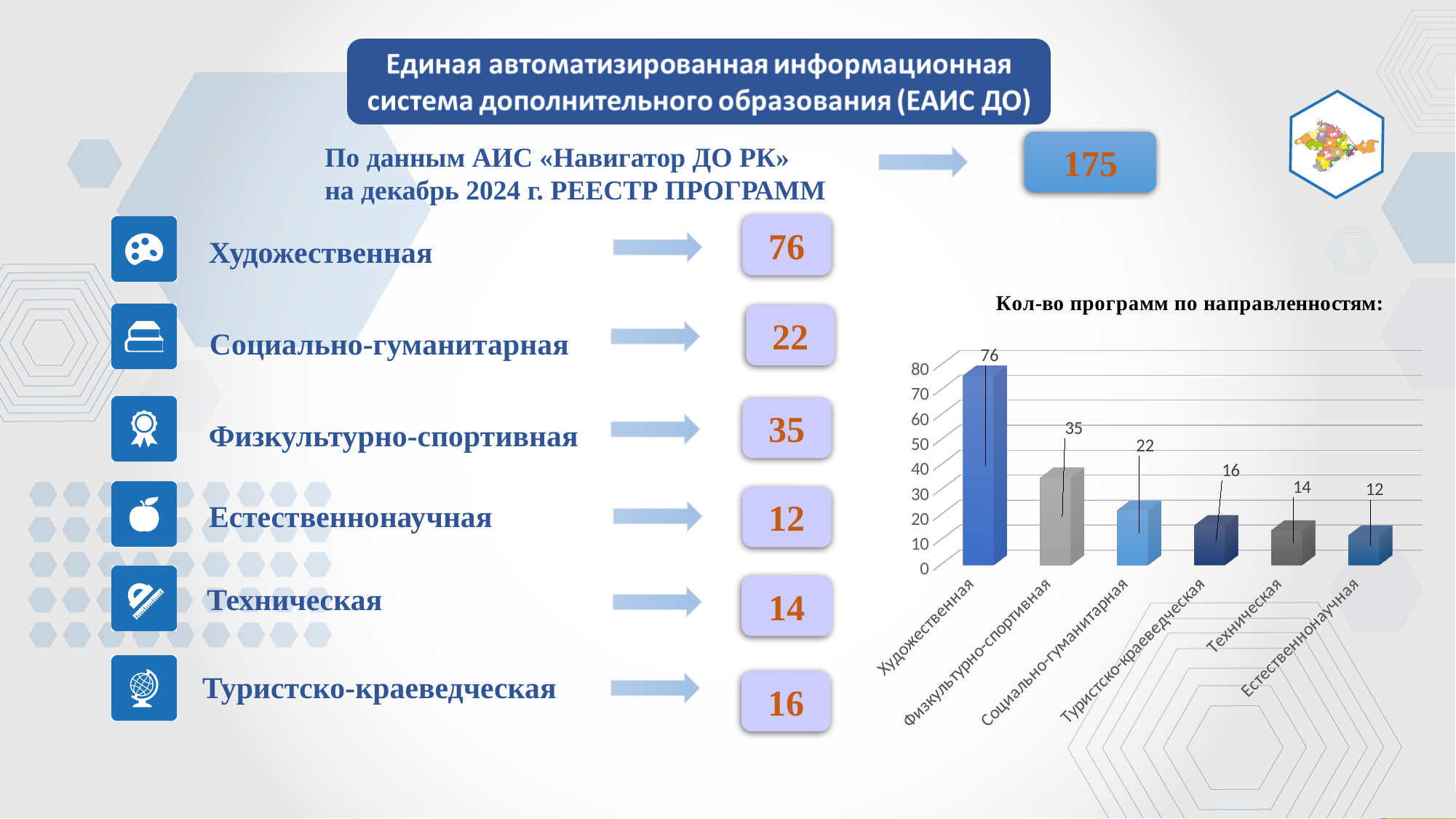
Which category has the lowest value in the chart? Естественнонаучная What kind of chart is shown on the slide? bar chart What is the title of the chart? Кол-во программ по направленностям: Which is larger, the value for Социально-гуманитарная or the value for Техническая? Социально-гуманитарная What is the value for Художественная in the chart? 76 Do the values rise or fall from left to right along the x axis? fall What is the value for Физкультурно-спортивная in the chart? 35 Which category has the highest value in the chart? Художественная How many categories are shown in the chart? 6 What is the value for Туристско-краеведческая in the chart? 16 What is the difference between the values for Художественная and Физкультурно-спортивная? 41 Is the value for Физкультурно-спортивная greater or less than 30? greater